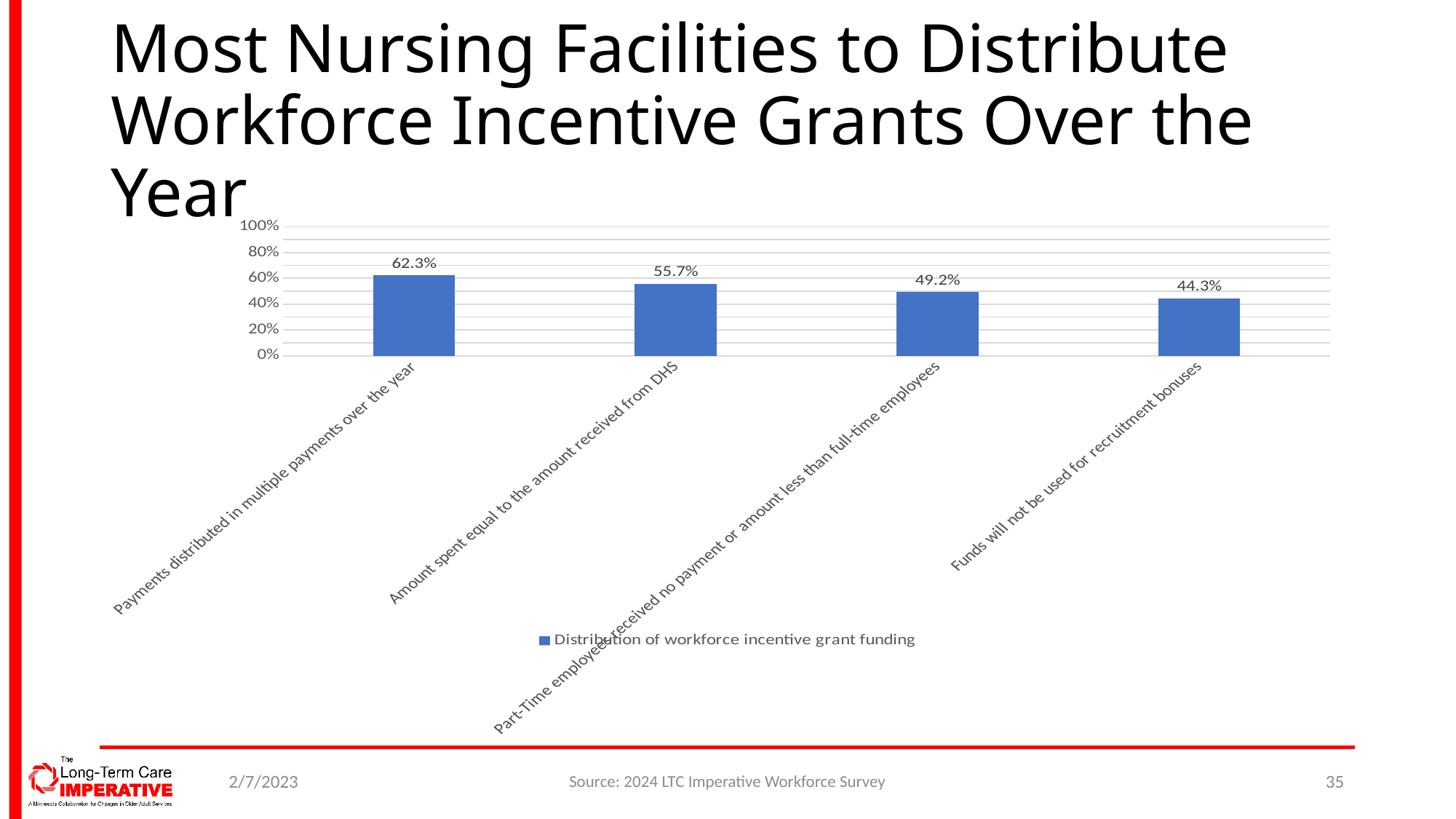
What is the value for 'Payments distributed in multiple payments over the year'? 62.3% How many series does the legend list? 1 What kind of chart is shown on the slide? Bar chart Which category has the lowest value? Funds will not be used for recruitment bonuses Which category has the highest value? Payments distributed in multiple payments over the year What is the value for 'Funds will not be used for recruitment bonuses'? 44.3% How many categories are shown in the chart? 4 What is the value for 'Part-Time employees received no payment or amount less than full-time employees'? 49.2% What is the difference between the values for 'Payments distributed in multiple payments over the year' and 'Funds will not be used for recruitment bonuses'? 18.0% What is the legend entry for the series shown in the chart? Distribution of workforce incentive grant funding What is the value for 'Amount spent equal to the amount received from DHS'? 55.7% Which is larger: the value for 'Amount spent equal to the amount received from DHS' or the value for 'Part-Time employees received no payment or amount less than full-time employees'? Amount spent equal to the amount received from DHS